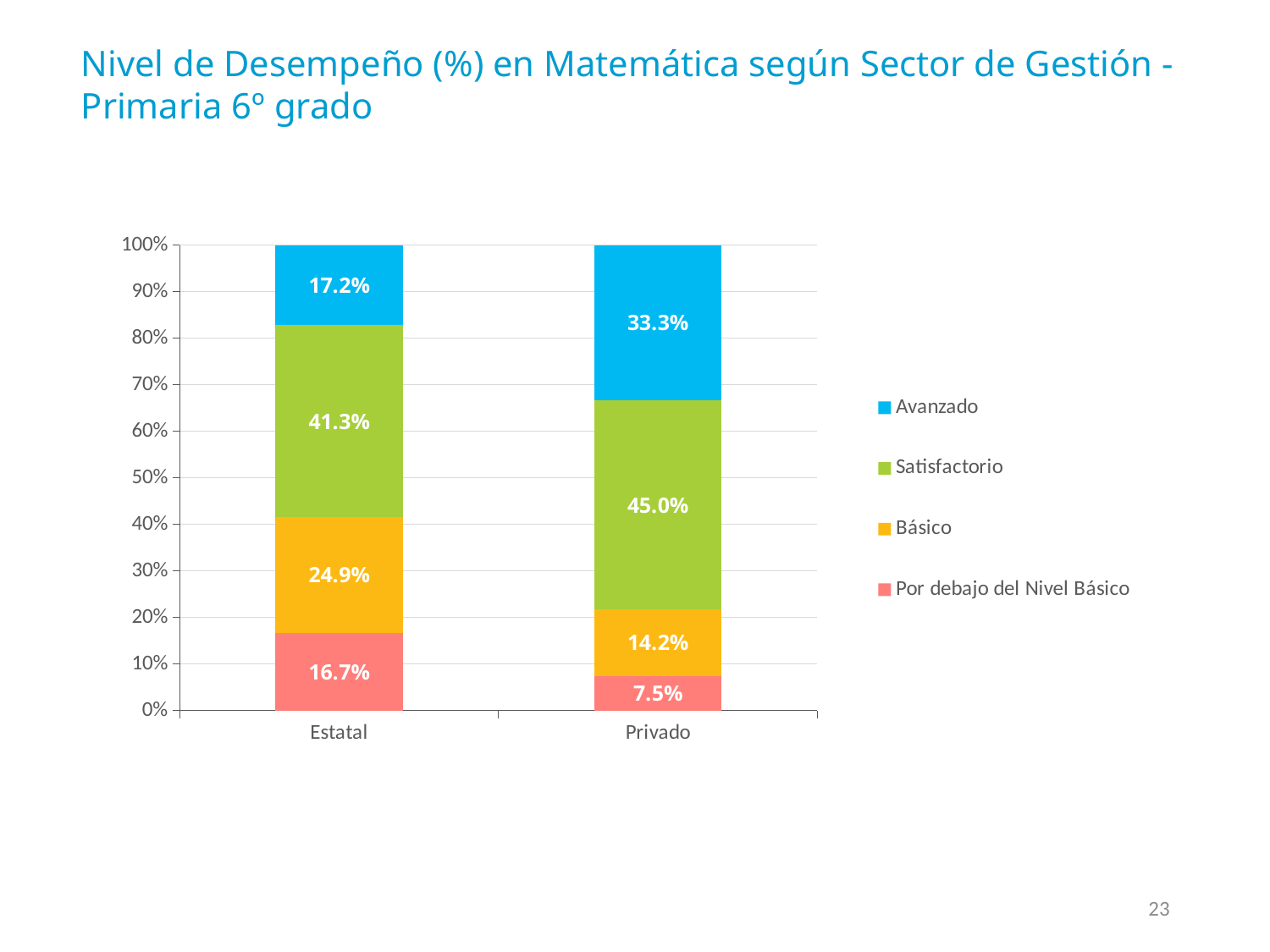
How many series does the legend list? 4 What kind of chart is shown? Stacked bar chart What is the Avanzado value for Estatal? 17.2% Which legend entry is shown in blue? Avanzado What is the difference between the Básico values for Estatal and Privado? 10.7% How many sectors are shown on the x axis? 2 What is the Básico value for Estatal? 24.9% Which sector has the lower Por debajo del Nivel Básico value? Privado What is the Satisfactorio value for Privado? 45.0% Which sector has the higher Avanzado value? Privado What is the Por debajo del Nivel Básico value for Privado? 7.5% What is the difference between the Avanzado values for Privado and Estatal? 16.1%